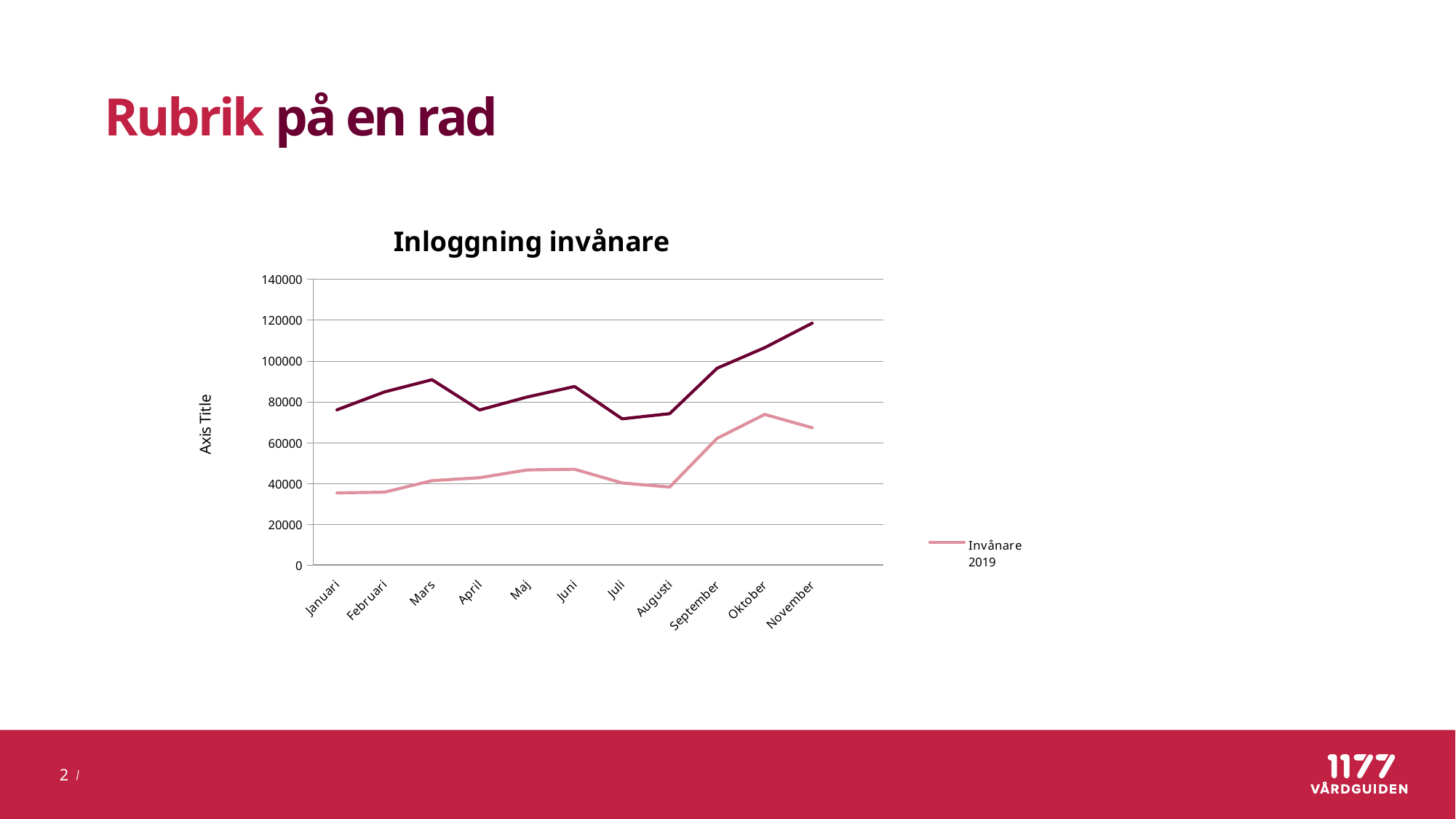
Does the Invånare 2019 line rise or fall from Juni to Augusti? fall Which is larger for Invånare 2019, the value in Maj or the value in Augusti? Maj Is the value for Invånare 2019 in Oktober greater or less than 60000? greater What kind of chart is shown on the slide? Line chart What is the label shown on the vertical axis of the chart? Axis Title Does the Invånare 2019 line rise or fall from Augusti to Oktober? rise What is the title of the chart? Inloggning invånare Is the value for Invånare 2019 in Januari greater or less than 40000? less Is the value for Invånare 2019 in Juni greater or less than 40000? greater How many months are shown along the x axis of the chart? 11 How many series does the chart's legend list? 1 In which month does the Invånare 2019 line reach its highest value? Oktober